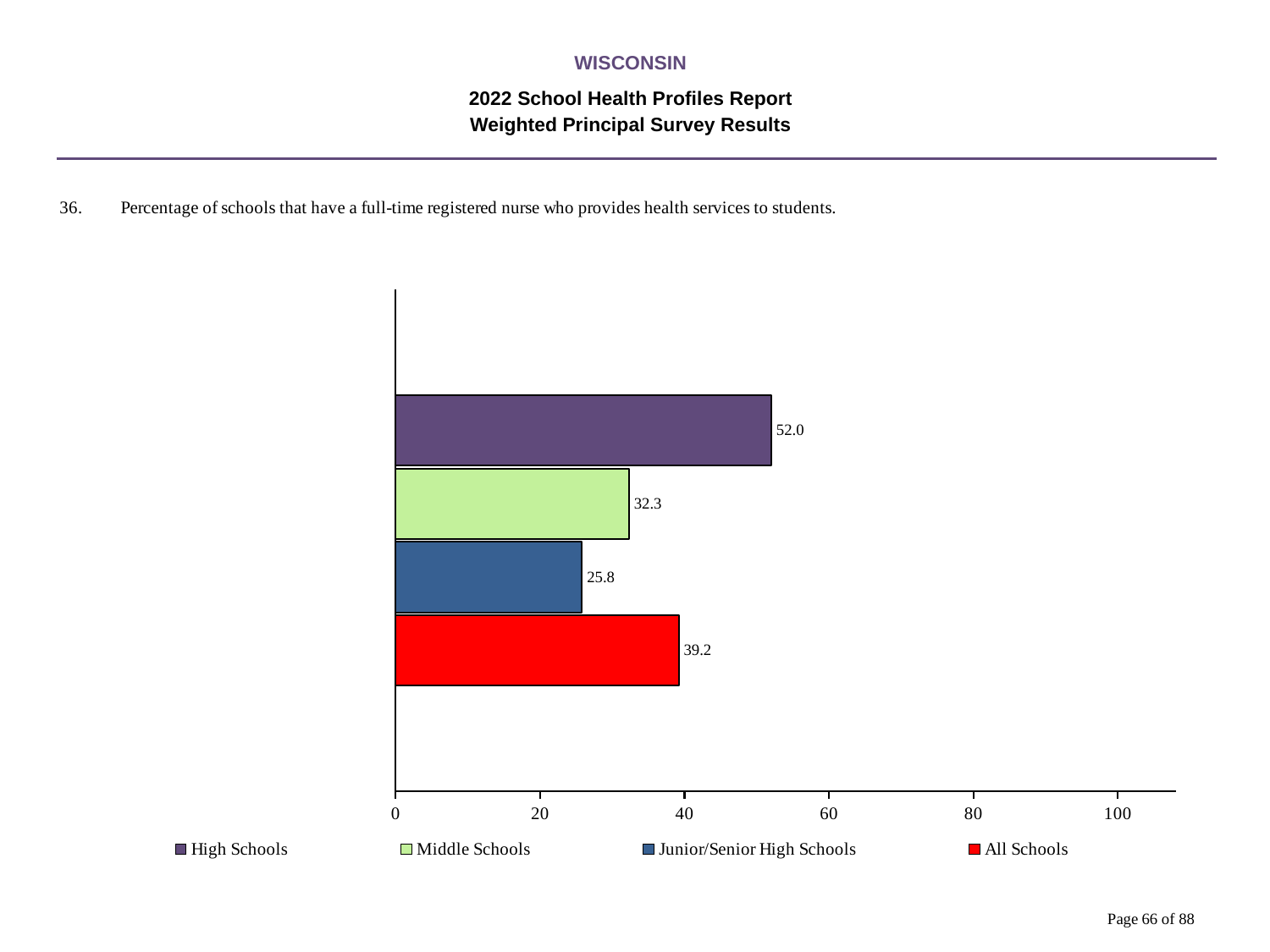
Which is larger, the value for Middle Schools or the value for All Schools? All Schools What is the value for All Schools? 39.2 What is the value for Junior/Senior High Schools? 25.8 What is the value for Middle Schools? 32.3 What colour is the bar for All Schools? Red What is the difference between the values for All Schools and Junior/Senior High Schools? 13.4 What is the difference between the values for High Schools and Middle Schools? 19.7 Which school type has the highest value? High Schools What kind of chart is shown on the slide? Bar chart Which school type has the lowest value? Junior/Senior High Schools What is the value for High Schools? 52.0 How many series does the legend list? 4